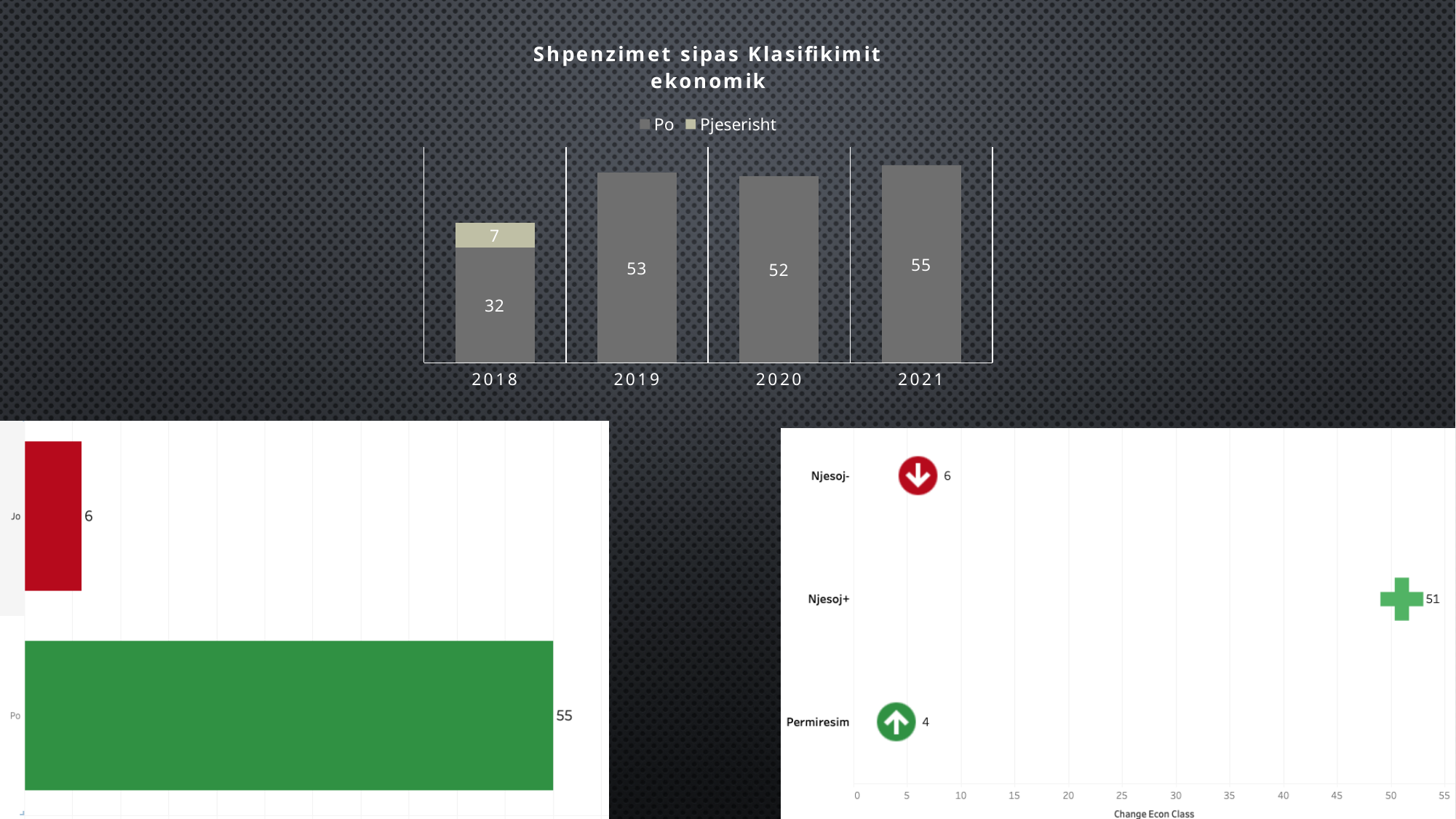
In the chart titled "Shpenzimet sipas Klasifikimit ekonomik", what is the value of the Pjeserisht series for 2018? 7 In the chart titled "Shpenzimet sipas Klasifikimit ekonomik", what is the difference between the Po values for 2021 and 2020? 3 In the bottom-right chart labelled "Change Econ Class", which category has the lowest value? Permiresim In the chart titled "Shpenzimet sipas Klasifikimit ekonomik", which year has the highest Po value? 2021 In the chart titled "Shpenzimet sipas Klasifikimit ekonomik", how many years are shown on the x axis? 4 What kind of chart is the one in the bottom-left of the slide? Bar chart In the chart titled "Shpenzimet sipas Klasifikimit ekonomik", what is the value of the Po series for 2019? 53 In the bottom-right chart labelled "Change Econ Class", what is the value for Njesoj+? 51 In the bottom-left chart, what is the value for Jo? 6 In the chart titled "Shpenzimet sipas Klasifikimit ekonomik", how many series does the legend list? 2 In the chart titled "Shpenzimet sipas Klasifikimit ekonomik", what is the total of the stacked bar for 2018? 39 In the bottom-left chart, which category is larger, Po or Jo? Po